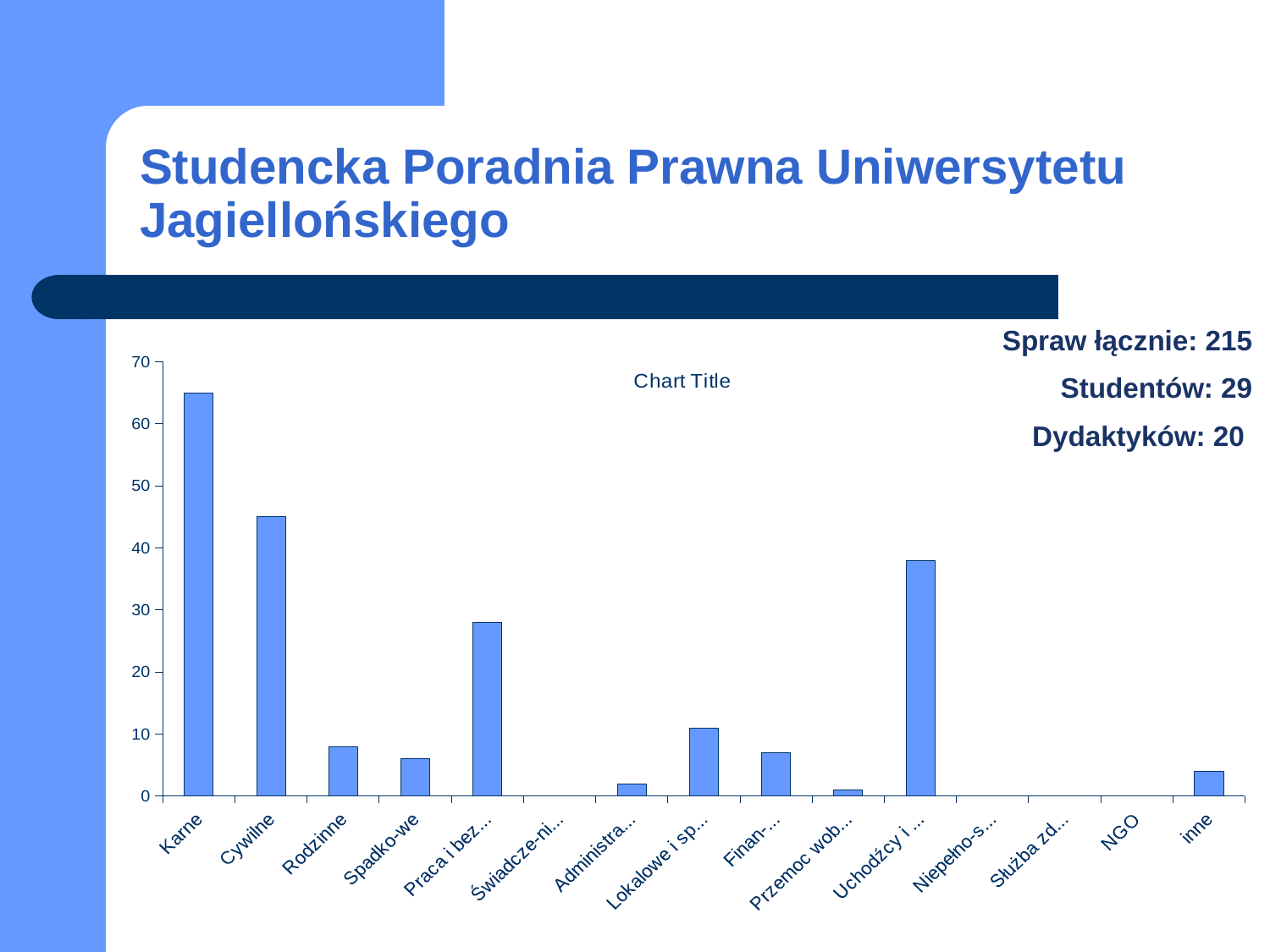
What is the highest value shown on the vertical axis of the chart? 70 How many categories are shown on the x axis of the chart? 15 What is the title shown on the chart? Chart Title Is the value for Cywilne greater or less than 40? greater Which is larger, the value for Cywilne or the value for inne? Cywilne Which category has the highest value in the chart? Karne Is the value for Karne greater or less than 60? greater Is the value for inne greater or less than 10? less What kind of chart is shown on the slide? bar chart Which is larger, the value for Karne or the value for Cywilne? Karne